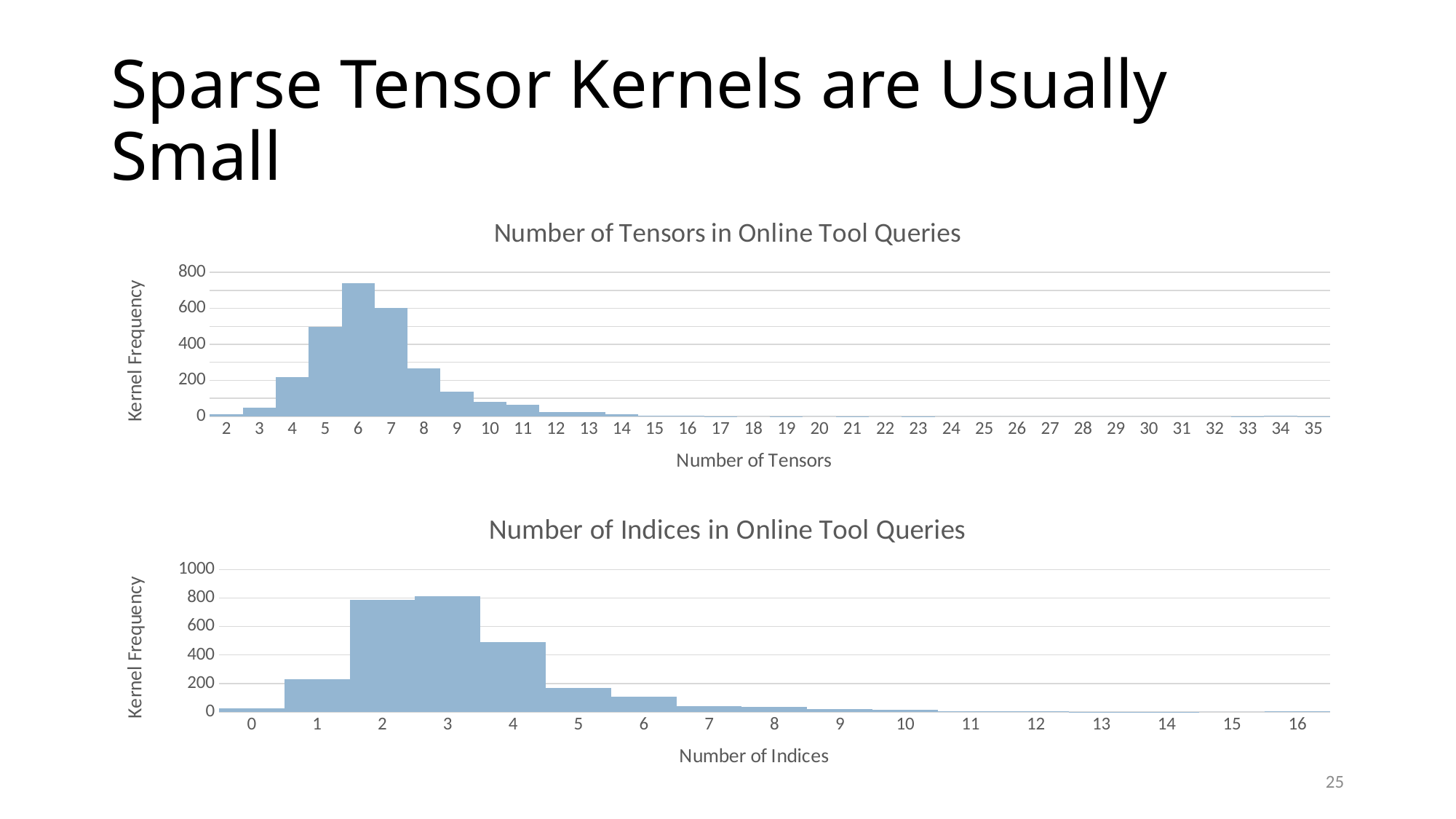
In the chart titled "Number of Indices in Online Tool Queries", is the kernel frequency for 4 indices greater or less than 400? greater What kind of chart is the chart titled "Number of Indices in Online Tool Queries"? bar chart In the chart titled "Number of Indices in Online Tool Queries", is the kernel frequency for 5 indices greater or less than 200? less In the chart titled "Number of Indices in Online Tool Queries", how many categories are shown on the x axis? 17 In the chart titled "Number of Indices in Online Tool Queries", which has a higher kernel frequency: 2 indices or 4 indices? 2 indices In the chart titled "Number of Tensors in Online Tool Queries", what is the label of the x axis? Number of Tensors In the chart titled "Number of Tensors in Online Tool Queries", which number of tensors has the highest kernel frequency? 6 In the chart titled "Number of Tensors in Online Tool Queries", which has a higher kernel frequency: 7 tensors or 8 tensors? 7 tensors In the chart titled "Number of Tensors in Online Tool Queries", is the kernel frequency for 5 tensors greater or less than 400? greater In the chart titled "Number of Indices in Online Tool Queries", do the kernel frequencies rise or fall from 4 indices to 10 indices? fall